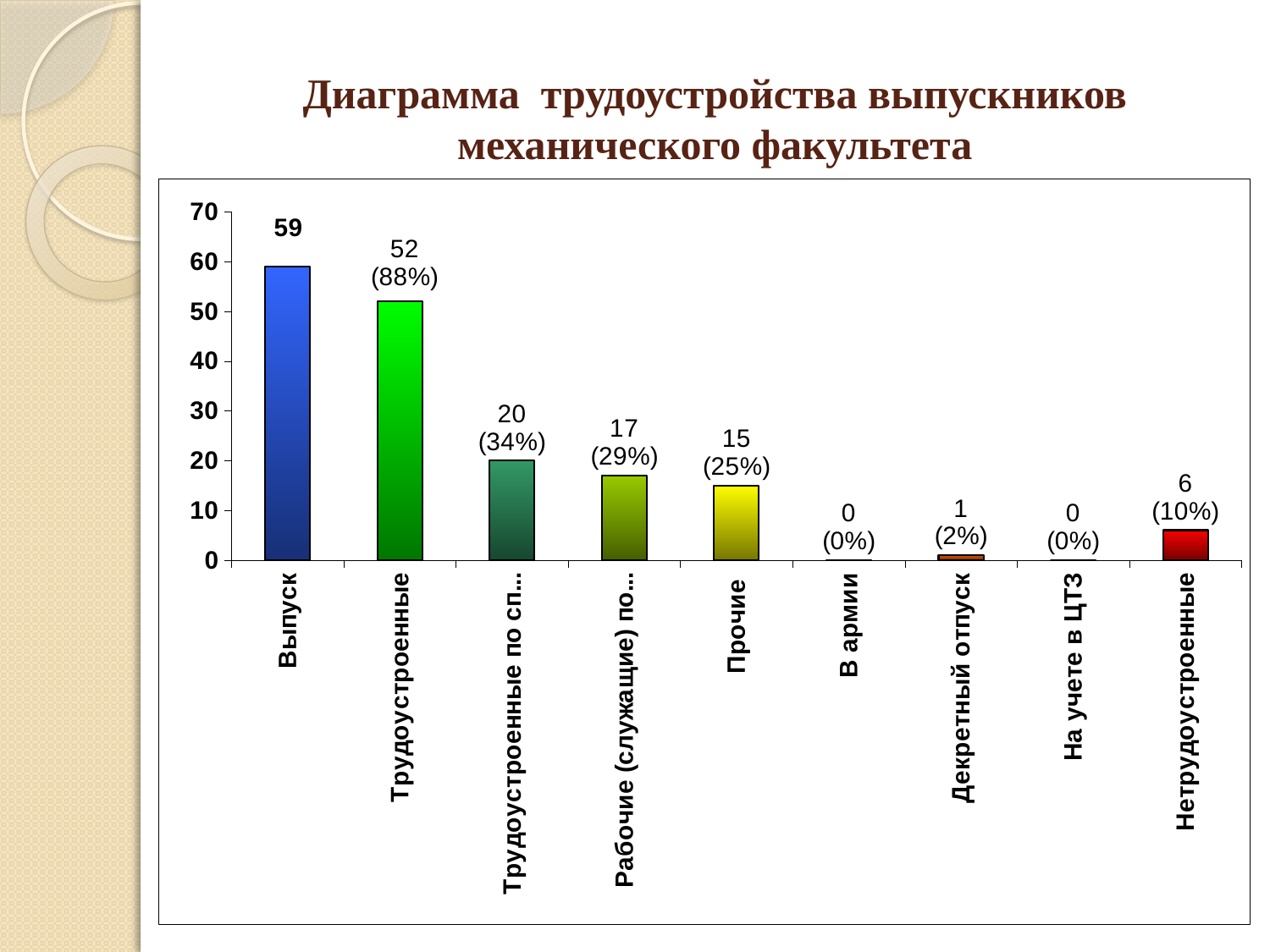
What is the value for Трудоустроенные? 52 Which is larger, the value for Прочие or the value for Нетрудоустроенные? Прочие Which category has the highest value? Выпуск What percentage is shown for Декретный отпуск? 2% What type of chart is shown on the slide? bar chart How many categories are shown on the x axis? 9 What percentage is shown for Трудоустроенные? 88% What is the value for Прочие? 15 What is the value for Нетрудоустроенные? 6 What is the title of the slide? Диаграмма трудоустройства выпускников механического факультета What is the value for Выпуск? 59 What is the difference between the values for Выпуск and Трудоустроенные? 7